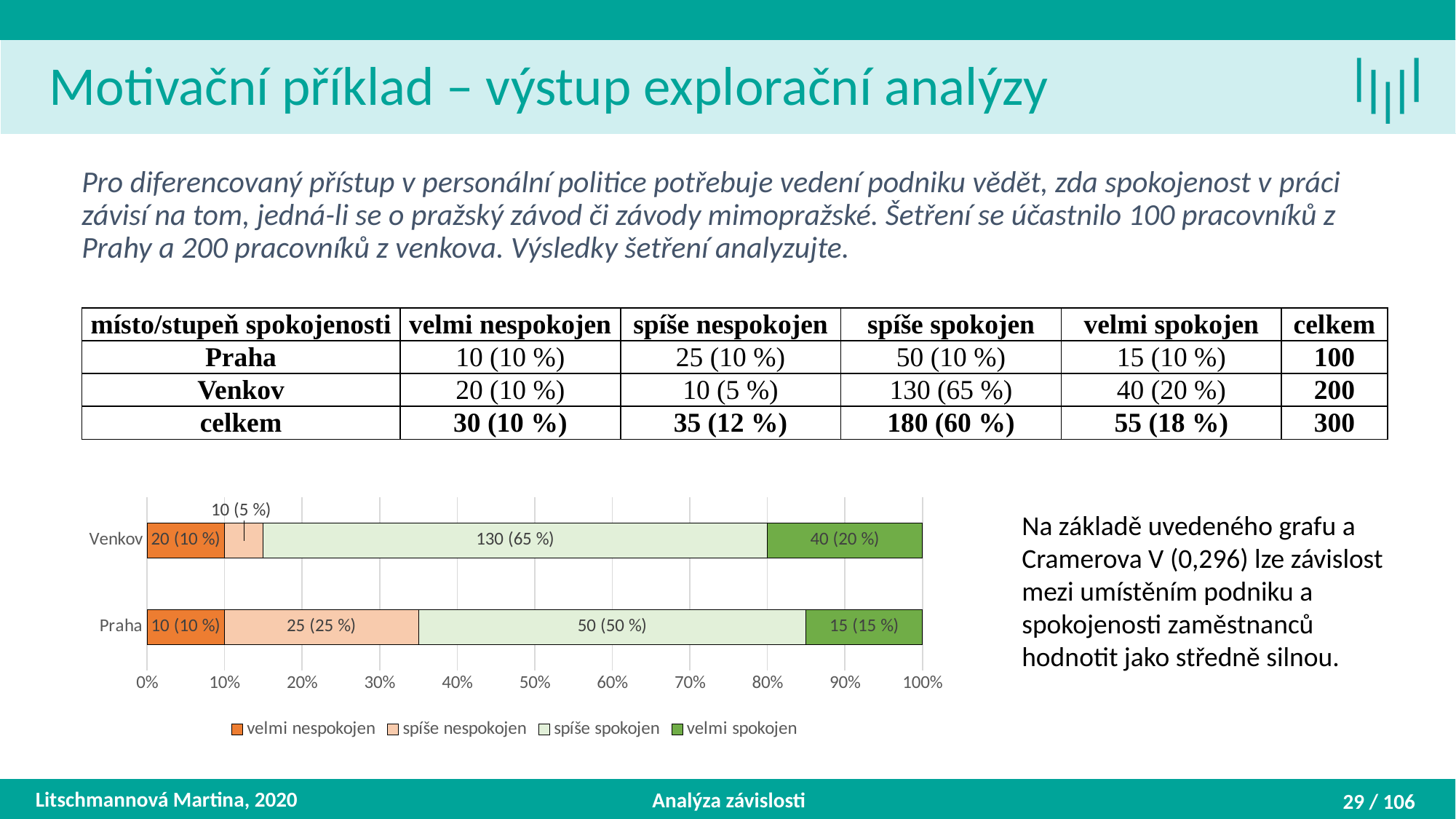
What is the data label for 'velmi spokojen' in the Venkov bar? 40 (20 %) What is the data label for 'velmi nespokojen' in the Praha bar? 10 (10 %) Which series is shown in dark green in the chart legend? velmi spokojen What is the data label for 'spíše nespokojen' in the Praha bar? 25 (25 %) What is the data label for 'spíše spokojen' in the Venkov bar? 130 (65 %) Which is larger: the 'velmi spokojen' share for Venkov or for Praha? Venkov Which segment of the Praha bar is the largest? spíše spokojen Which segment of the Venkov bar is the smallest? spíše nespokojen How many series does the chart legend list? 4 What is the difference in count between 'spíše spokojen' for Venkov and for Praha? 80 What kind of chart is shown on the slide? stacked bar chart How many categories (bars) are shown in the chart? 2